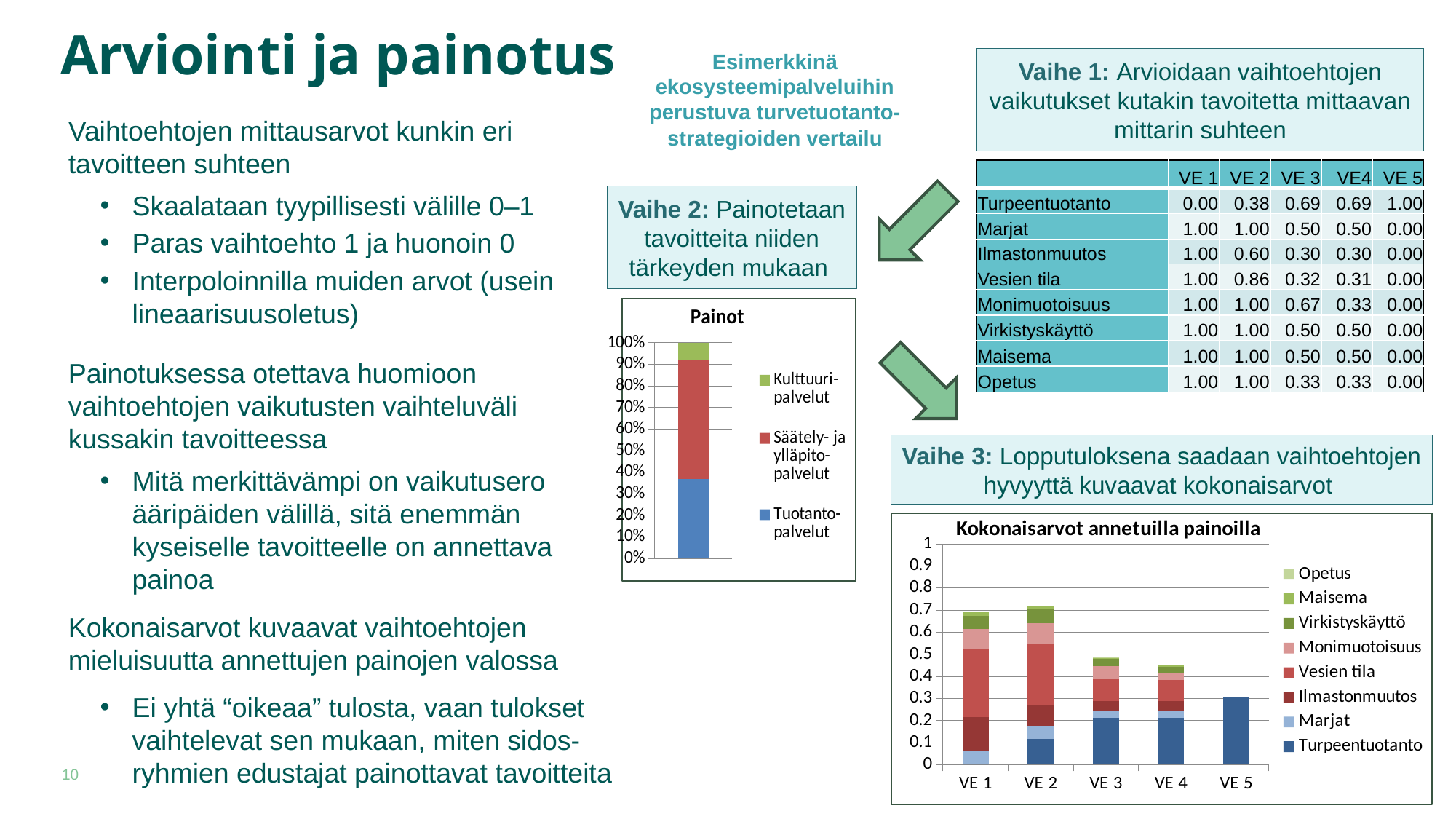
In the 'Painot' chart, which series has the smallest share of the bar? Kulttuuripalvelut How many series does the legend of the 'Kokonaisarvot annetuilla painoilla' chart list? 8 In the 'Kokonaisarvot annetuilla painoilla' chart, is the total for VE 5 greater or less than 0.4? less In the 'Painot' chart, is the share for Kulttuuripalvelut greater or less than 20%? less In the 'Painot' chart, which series has the largest share of the bar? Säätely- ja ylläpitopalvelut What kind of chart is the 'Painot' chart? bar chart In the 'Kokonaisarvot annetuilla painoilla' chart, is the total for VE 1 greater or less than 0.6? greater In the 'Kokonaisarvot annetuilla painoilla' chart, which category has the lowest total? VE 5 How many categories are shown on the x axis of the 'Kokonaisarvot annetuilla painoilla' chart? 5 In the 'Kokonaisarvot annetuilla painoilla' chart, which is larger, the total for VE 1 or the total for VE 4? VE 1 How many series does the legend of the 'Painot' chart list? 3